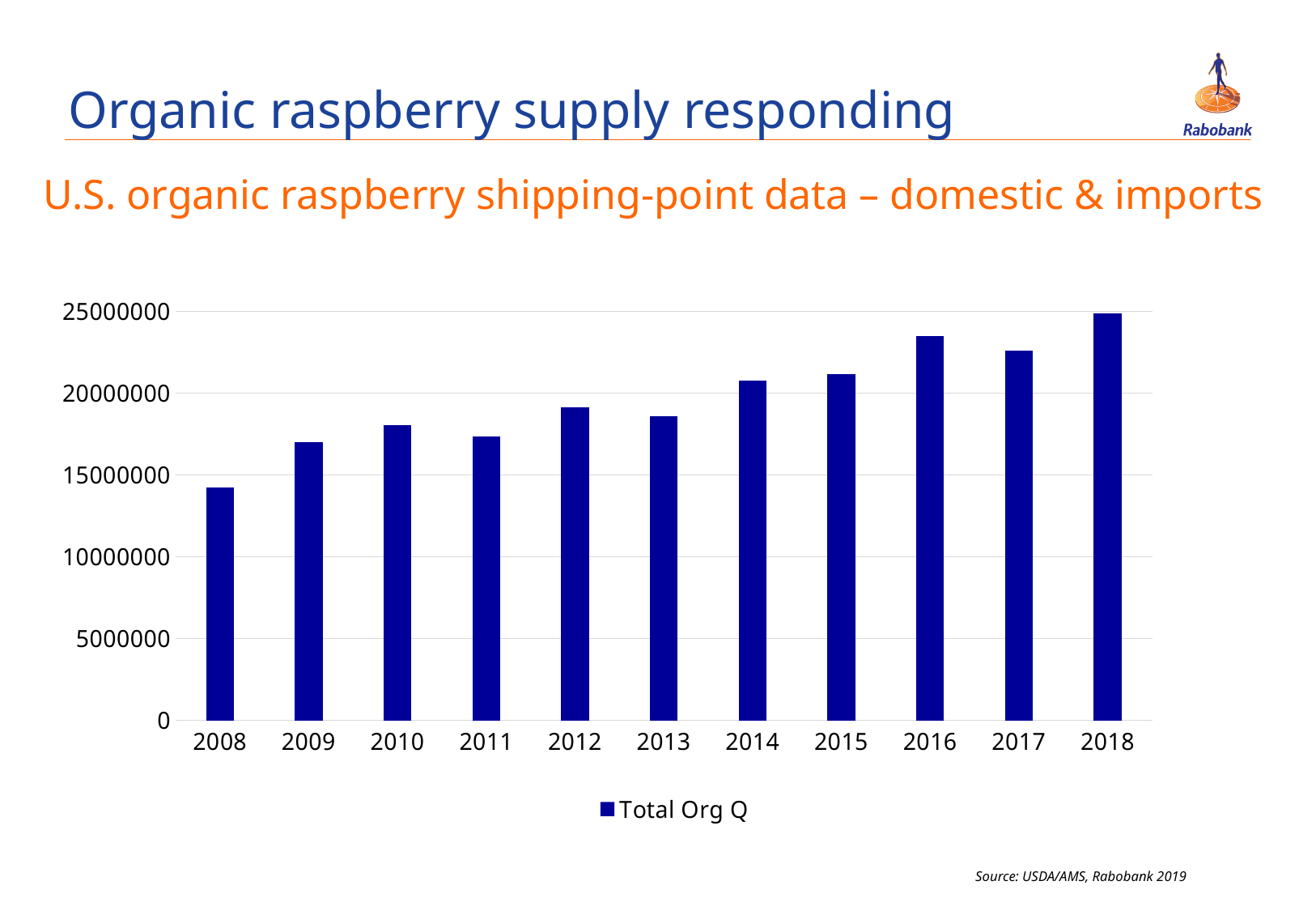
Which year has the lowest value in the chart? 2008 Is the value for 2008 greater or less than 15000000? less Is the value for 2009 greater or less than 15000000? greater What kind of chart is shown on the slide? bar chart Is the value for 2014 greater or less than 20000000? greater How many series does the chart's legend list? 1 How many years are shown on the x axis of the chart? 11 Do the values generally rise or fall from 2008 to 2018? rise What is the name of the series listed in the chart's legend? Total Org Q Which year has the highest value in the chart? 2018 Which year has the larger value, 2016 or 2017? 2016